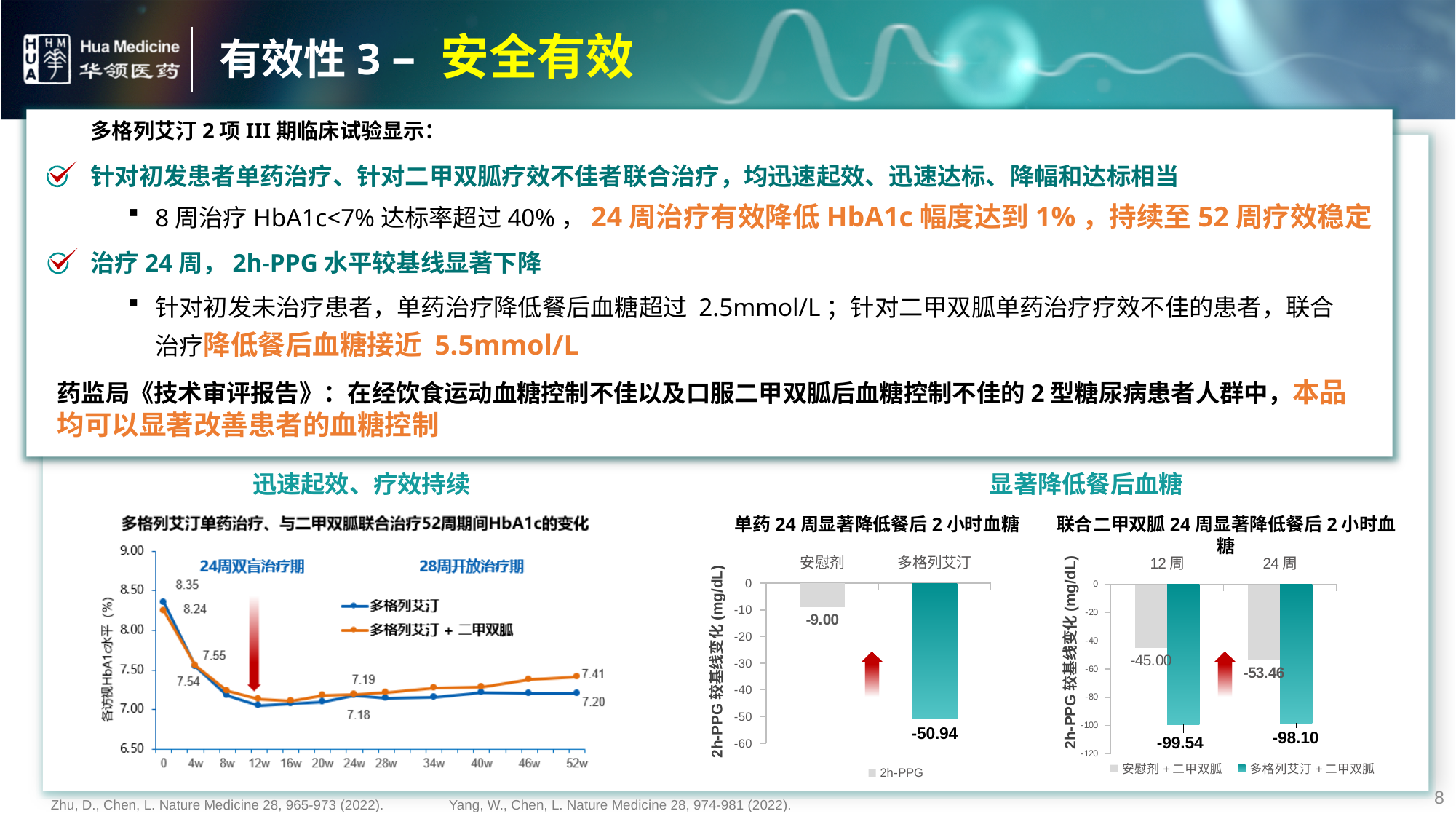
In the chart titled 多格列艾汀单药治疗、与二甲双胍联合治疗52周期间HbA1c的变化, how many time points are shown on the x axis? 12 In the chart titled 多格列艾汀单药治疗、与二甲双胍联合治疗52周期间HbA1c的变化, what is the value of the 多格列艾汀 + 二甲双胍 series at 52w? 7.41 In the chart titled 单药 24 周显著降低餐后 2 小时血糖, what is the value for 多格列艾汀? -50.94 In the chart titled 联合二甲双胍 24 周显著降低餐后 2 小时血糖, what is the value for 安慰剂 + 二甲双胍 at 24 周? -53.46 In the chart titled 单药 24 周显著降低餐后 2 小时血糖, what kind of chart is it? bar chart In the chart titled 多格列艾汀单药治疗、与二甲双胍联合治疗52周期间HbA1c的变化, does the 多格列艾汀 series rise or fall between 0 and 12w? fall In the chart titled 单药 24 周显著降低餐后 2 小时血糖, what is the value for 安慰剂? -9.00 In the chart titled 多格列艾汀单药治疗、与二甲双胍联合治疗52周期间HbA1c的变化, what kind of chart is it? line chart In the chart titled 多格列艾汀单药治疗、与二甲双胍联合治疗52周期间HbA1c的变化, how many series does the legend list? 2 In the chart titled 联合二甲双胍 24 周显著降低餐后 2 小时血糖, what is the difference between the 多格列艾汀 + 二甲双胍 and 安慰剂 + 二甲双胍 values at 24 周? 44.64 In the chart titled 多格列艾汀单药治疗、与二甲双胍联合治疗52周期间HbA1c的变化, what is the value of the 多格列艾汀 series at 52w? 7.20 In the chart titled 联合二甲双胍 24 周显著降低餐后 2 小时血糖, what is the value for 多格列艾汀 + 二甲双胍 at 12 周? -99.54